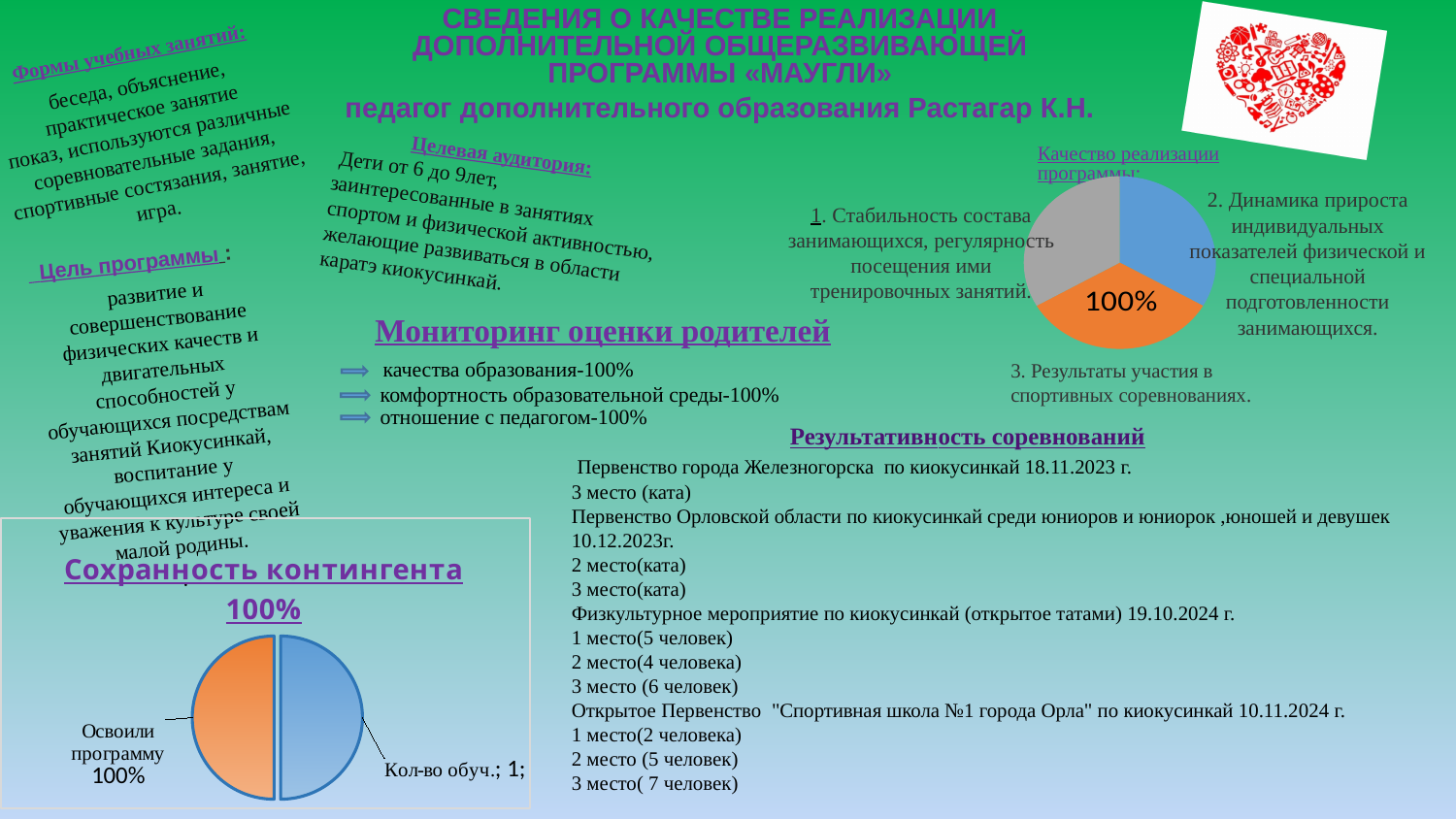
In the bottom-left chart 'Сохранность контингента', what colour is the 'Освоили программу' slice? orange In the bottom-left chart 'Сохранность контингента', what value is shown for 'Освоили программу'? 100% What kind of chart is the chart at the top right under 'Качество реализации программы'? pie chart In the top-right pie chart under 'Качество реализации программы', how many slices does the pie have? 3 What is the title of the pie chart in the bottom-left corner of the slide? Сохранность контингента 100% In the bottom-left chart 'Сохранность контингента', how many slices does the pie have? 2 What kind of chart is the bottom-left chart titled 'Сохранность контингента'? pie chart In the top-right pie chart under 'Качество реализации программы', what data label is printed on the orange slice? 100% In the bottom-left chart 'Сохранность контингента', what value is shown for 'Кол-во обуч.'? 1